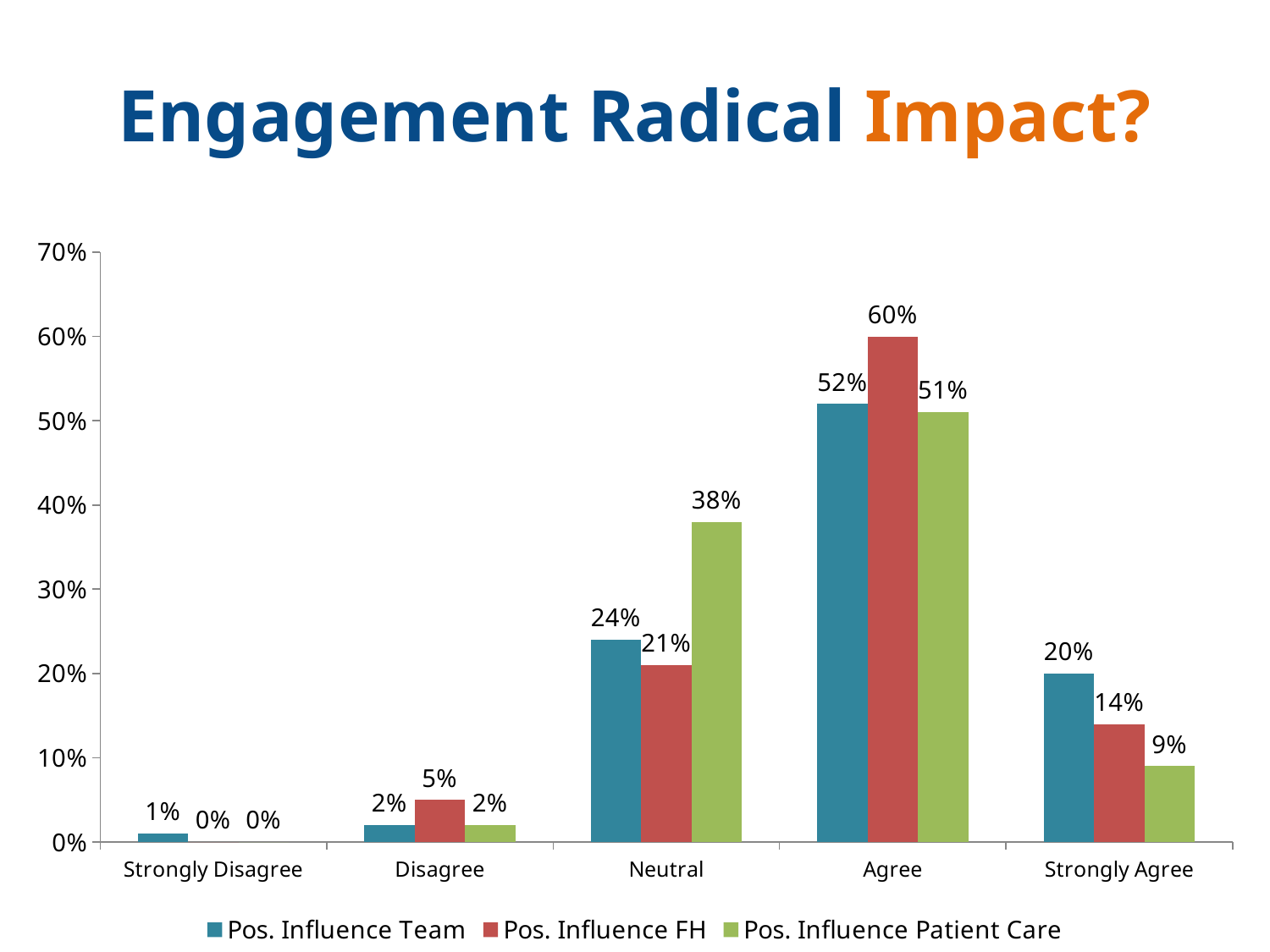
Is the value for Pos. Influence Patient Care in the Strongly Agree category greater or less than 10%? less What is the difference between Pos. Influence FH and Pos. Influence Team in the Agree category? 8% What is the value for Pos. Influence Team in the Strongly Agree category? 20% What is the value for Pos. Influence Patient Care in the Neutral category? 38% In the Neutral category, which series has the larger value: Pos. Influence Team or Pos. Influence FH? Pos. Influence Team How many categories are shown on the x axis? 5 What is the title of the slide? Engagement Radical Impact? Which category has the highest value for Pos. Influence Patient Care? Agree Which category has the lowest value for Pos. Influence Team? Strongly Disagree What is the value for Pos. Influence FH in the Agree category? 60% How many series does the legend list? 3 What kind of chart is shown on the slide? Bar chart